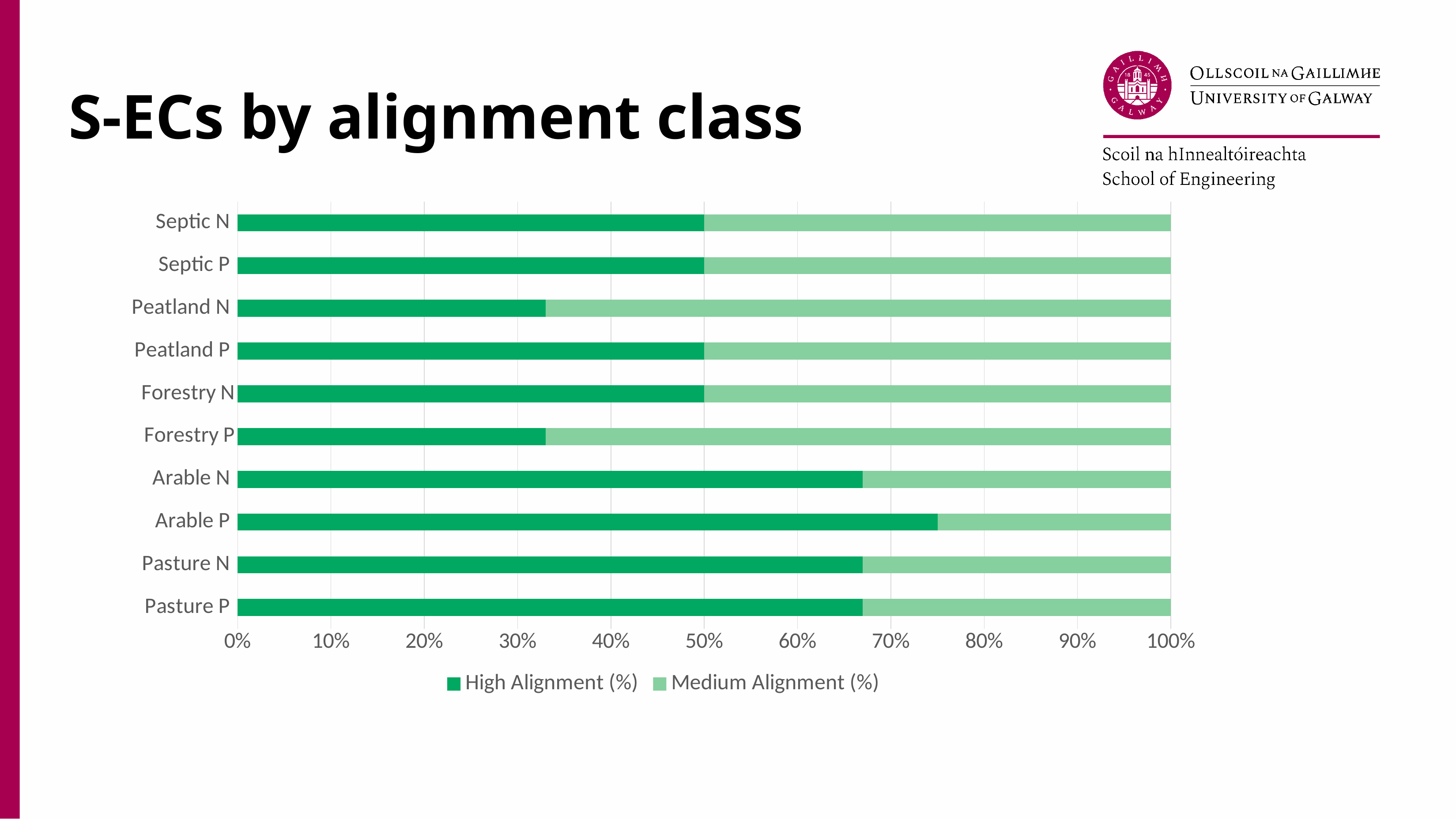
What is the High Alignment (%) value for Forestry N? 50% What is the total of the stacked bar for Arable P? 100% Is the High Alignment (%) value for Arable P greater or less than 70%? greater What is the title of the chart? S-ECs by alignment class What is the High Alignment (%) value for Septic N? 50% Which has the larger High Alignment (%) value, Peatland N or Peatland P? Peatland P What kind of chart is shown on the slide? Bar chart Is the High Alignment (%) value for Peatland N greater or less than 40%? less How many series does the legend list? 2 How many categories are shown on the vertical axis of the chart? 10 Which series is shown in the lighter green colour? Medium Alignment (%) Which category has the highest High Alignment (%) value? Arable P